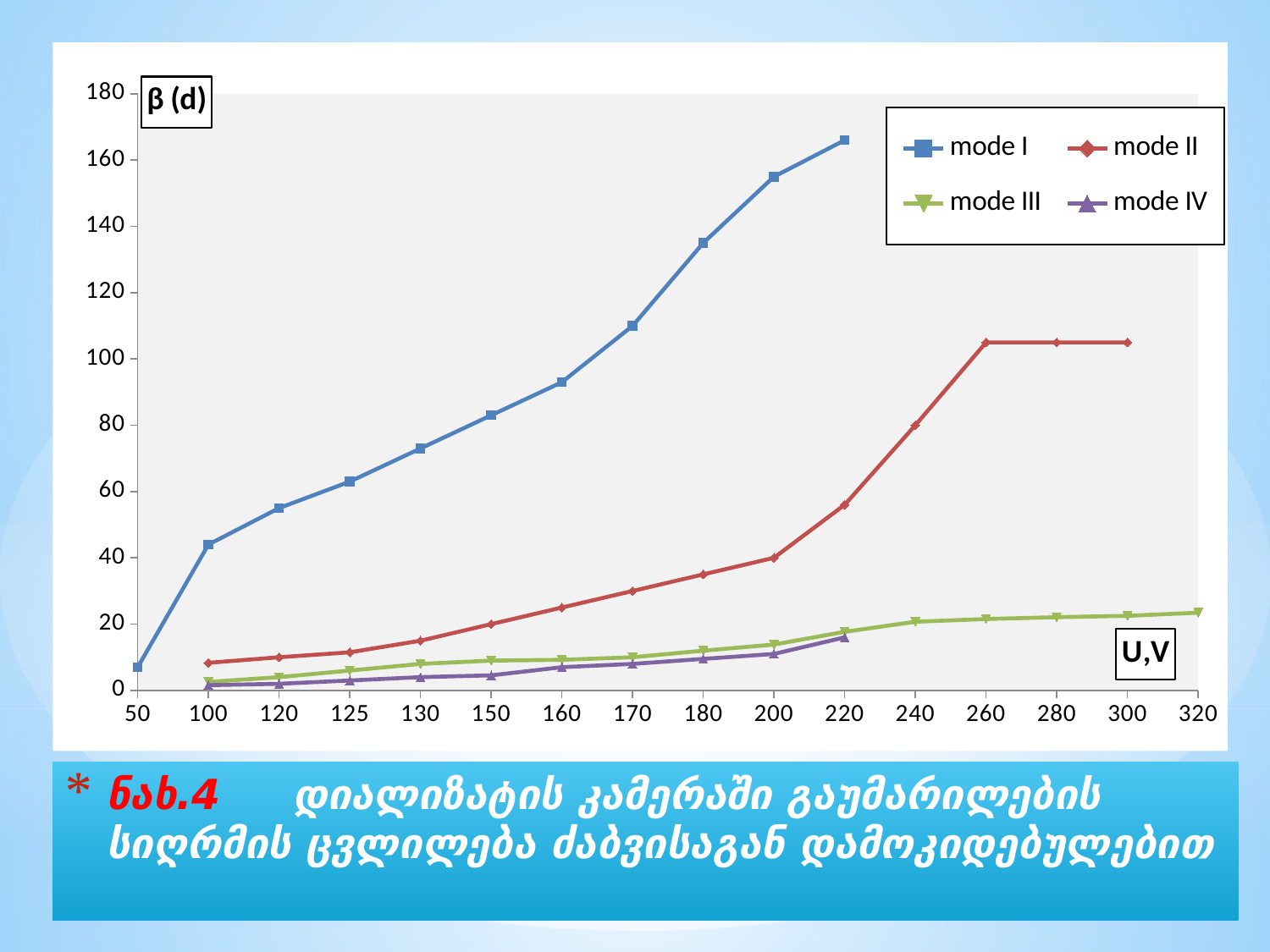
At 220, which series has the larger value, mode III or mode IV? mode III Is the value for mode I at 220 greater or less than 160? greater At 200, which series has the larger value, mode I or mode II? mode I Which series reaches the highest value on the chart? mode I Does the mode I series rise or fall as the x-axis value increases? rise Is the value for mode IV at 220 greater or less than 20? less How many series does the legend list? 4 What label is shown in the box at the bottom right of the plot area? U,V Is the value for mode I at 200 greater or less than 140? greater What kind of chart is shown on the slide? line chart